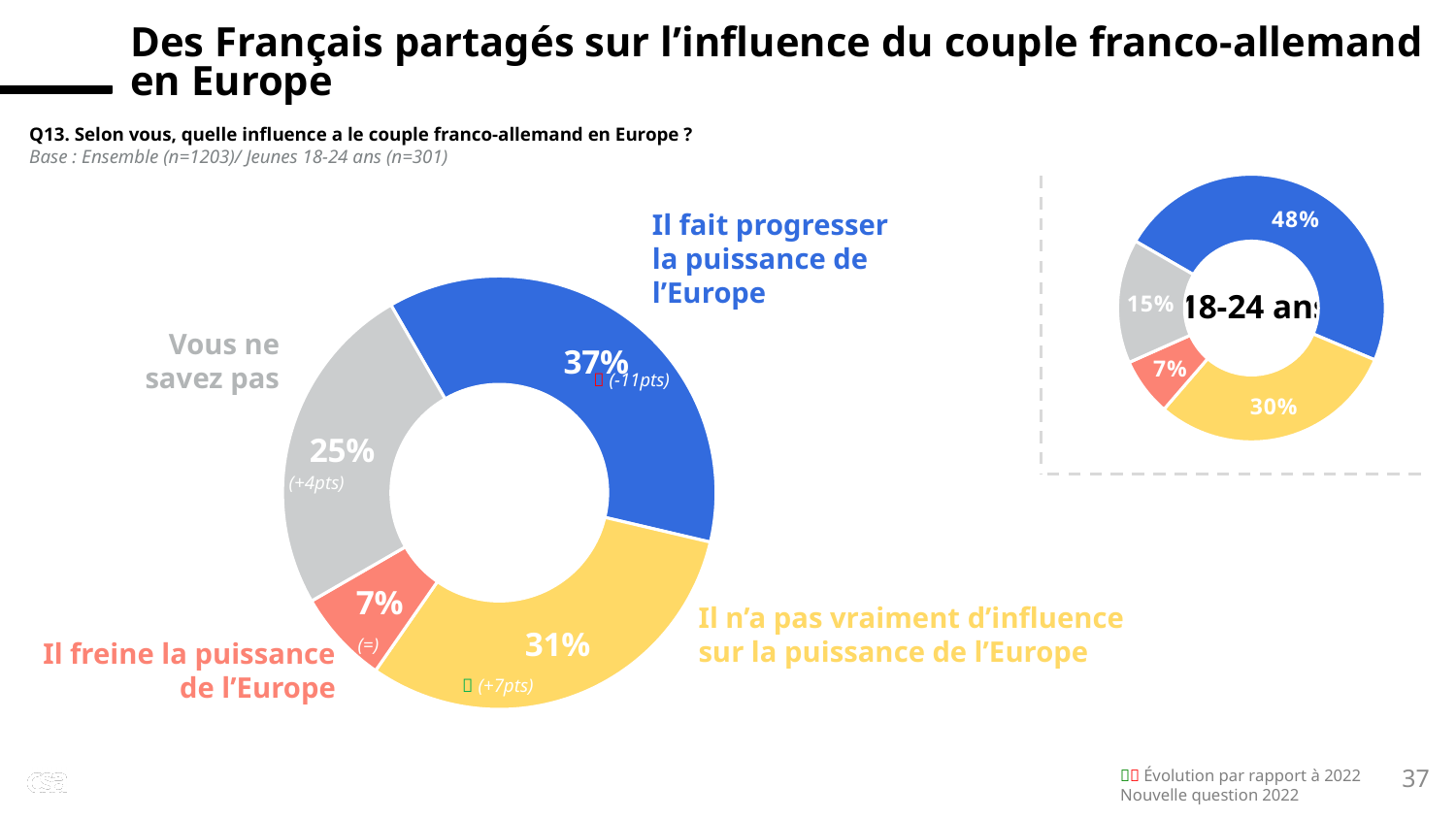
In the main donut chart, what percentage answered 'Vous ne savez pas'? 25% In the main donut chart, what percentage answered 'Il freine la puissance de l'Europe'? 7% In the main donut chart, what percentage answered 'Il n'a pas vraiment d'influence sur la puissance de l'Europe'? 31% What type of chart is used on this slide? Donut (pie) chart In the 18-24 ans donut chart, what is the value of the blue segment? 48% In the main donut chart, what share of respondents say the Franco-German couple 'fait progresser la puissance de l'Europe'? 37% In the 18-24 ans donut chart, what is the value of the grey segment? 15% In the main donut chart, what is the difference in percentage points between 'Il fait progresser la puissance de l'Europe' and 'Il n'a pas vraiment d'influence sur la puissance de l'Europe'? 6 points In the 18-24 ans donut chart, what is the value of the yellow segment? 30% In the main donut chart, what is the change since 2022 shown for 'Il fait progresser la puissance de l'Europe'? -11pts In the main donut chart, which response has the smallest share? Il freine la puissance de l'Europe In the main donut chart, which response has the largest share? Il fait progresser la puissance de l'Europe